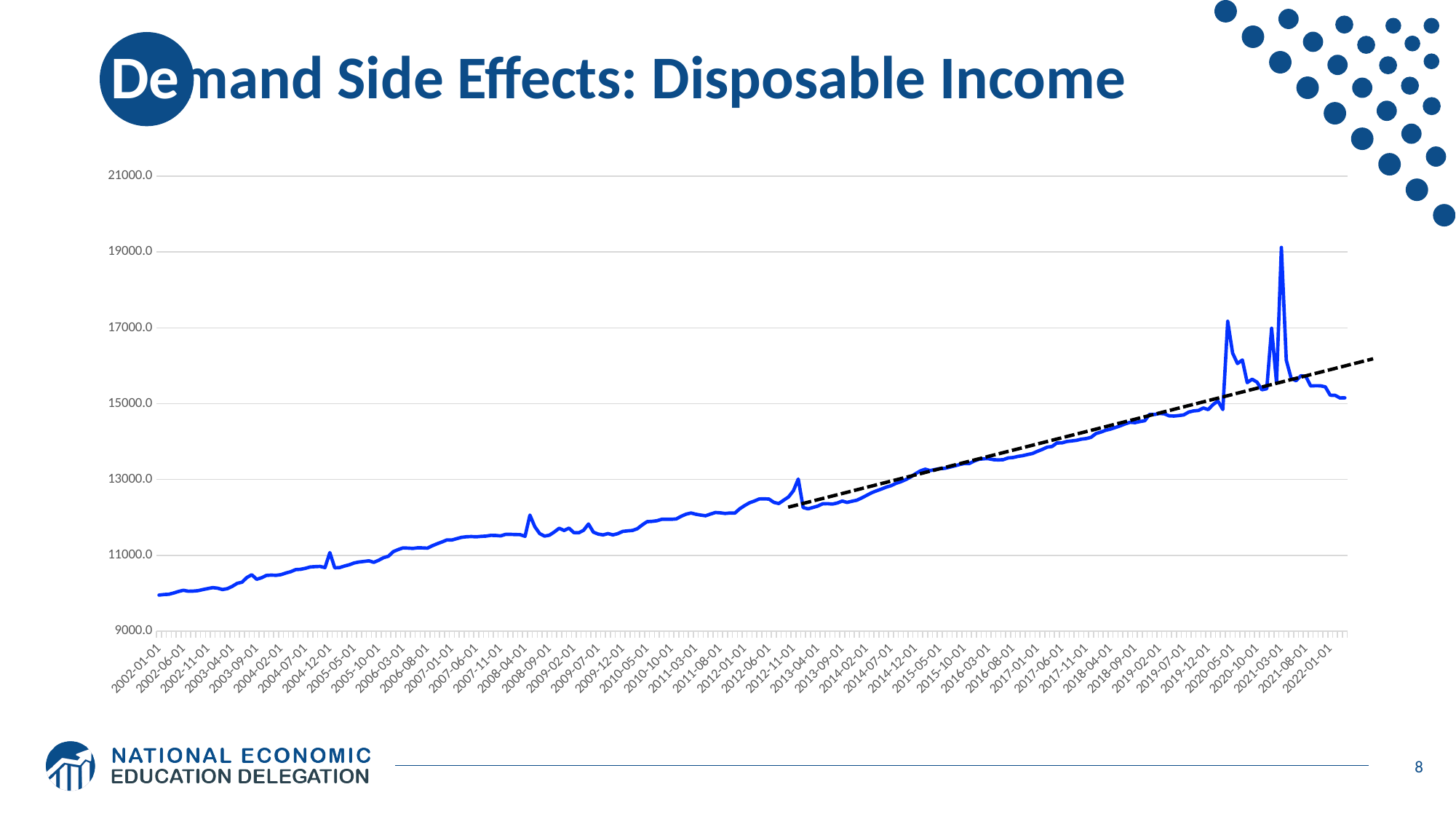
Is the highest peak of the blue line greater or less than 17000.0? greater What kind of chart is shown on the slide? line chart Is the value of the blue line at 2008-04-01 greater or less than 13000.0? less What colour is the solid data line on the chart? blue Is the value of the blue line at 2012-01-01 greater or less than 13000.0? less Overall, do the values of the blue line rise or fall from 2002-01-01 to 2022-01-01? rise What is the highest value shown on the vertical axis? 21000.0 Around which x-axis date is the blue line at its lowest value? 2002-01-01 Which is larger, the value of the blue line at 2022-01-01 or at 2002-01-01? 2022-01-01 Around which x-axis date does the blue line reach its highest peak? 2021-03-01